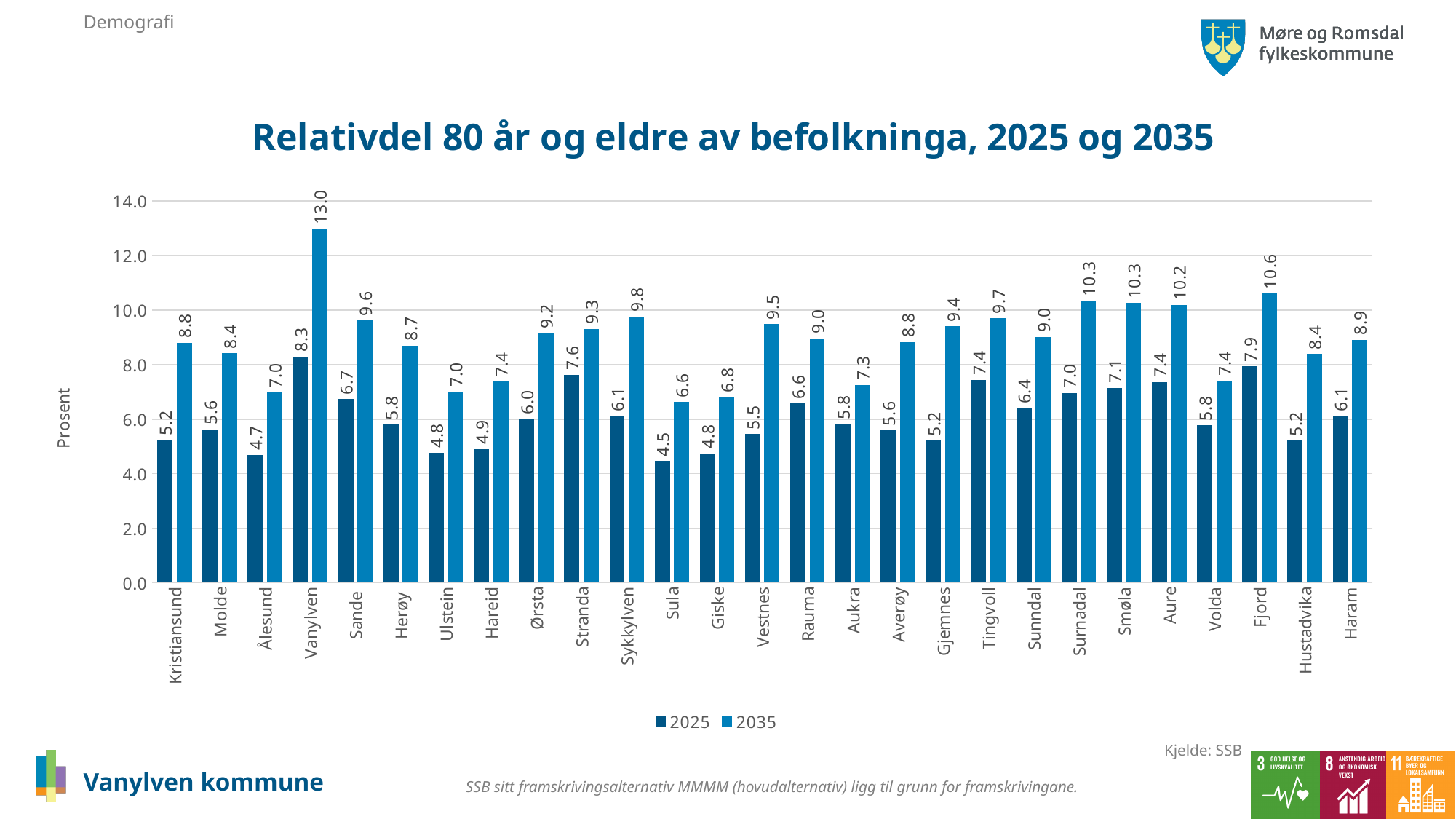
What is the value for Fjord in the 2035 series? 10.6 What is the value for Sula in the 2025 series? 4.5 Is the 2025 value for Stranda greater or less than 6.0? greater What is the label on the y axis? Prosent Which municipality has the highest value in the 2035 series? Vanylven What kind of chart is shown on the slide? Bar chart What is the value for Vanylven in the 2035 series? 13.0 How many municipalities are shown on the x axis? 27 Which municipality has the lowest value in the 2025 series? Sula What is the difference between the 2035 and 2025 values for Vanylven? 4.7 Which is larger: the 2035 value for Surnadal or the 2035 value for Aure? Surnadal How many series does the legend list? 2